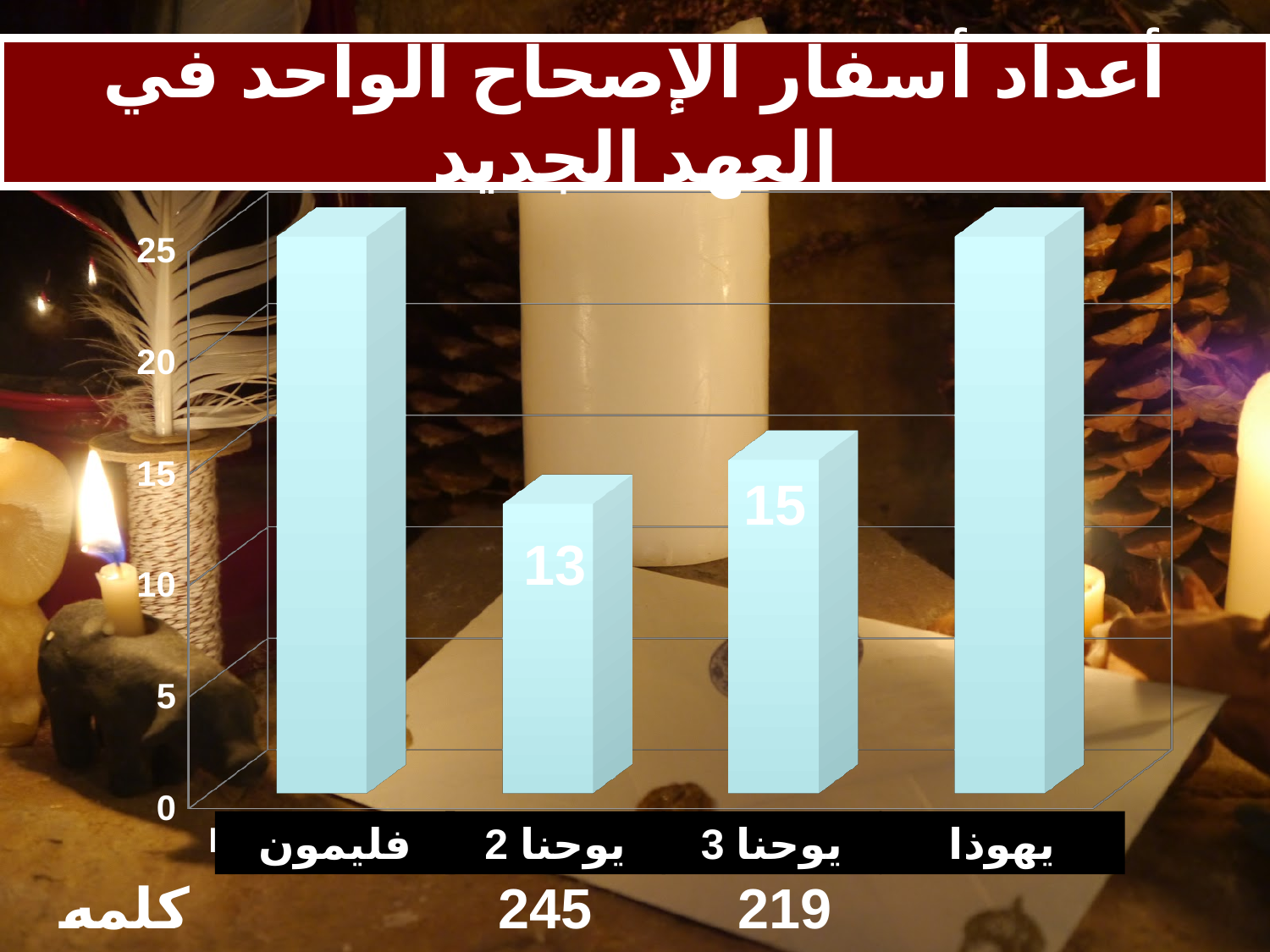
Is the value for يهوذا greater or less than 20? greater Is the value for فليمون greater or less than 20? greater Which category has the lowest value? يوحنا 2 What is the value for يوحنا 2? 13 Which has the larger value, يوحنا 2 or يوحنا 3? يوحنا 3 What is the value for يوحنا 3? 15 What is the title of the chart? أعداد أسفار الإصحاح الواحد في العهد الجديد What is the difference between the values for يوحنا 3 and يوحنا 2? 2 Is the value for يوحنا 2 greater or less than 15? less How many categories are shown on the x axis? 4 What kind of chart is shown on the slide? bar chart